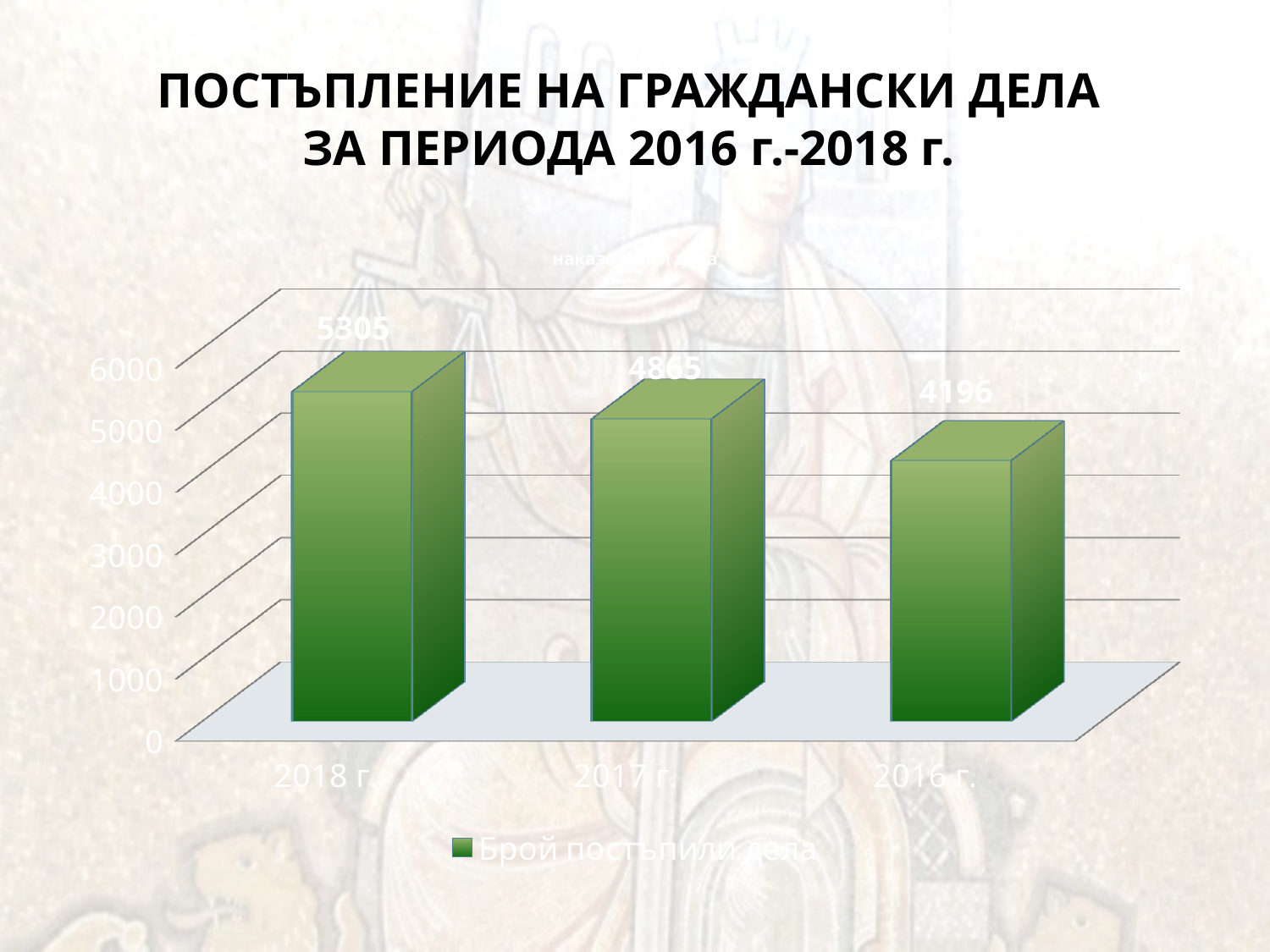
What kind of chart is shown on the slide? bar chart What is the value for 2017 г.? 4865 What is the difference between the values for 2018 г. and 2017 г.? 440 What is the legend entry of the series shown on the chart? Брой постъпили дела Which year has the highest value? 2018 г. Which is larger, the value for 2017 г. or the value for 2016 г.? 2017 г. Which year has the lowest value? 2016 г. What is the difference between the values for 2017 г. and 2016 г.? 669 What is the value for 2018 г.? 5305 Is the value for 2016 г. greater or less than 5000? less How many years are shown on the chart? 3 What is the value for 2016 г.? 4196